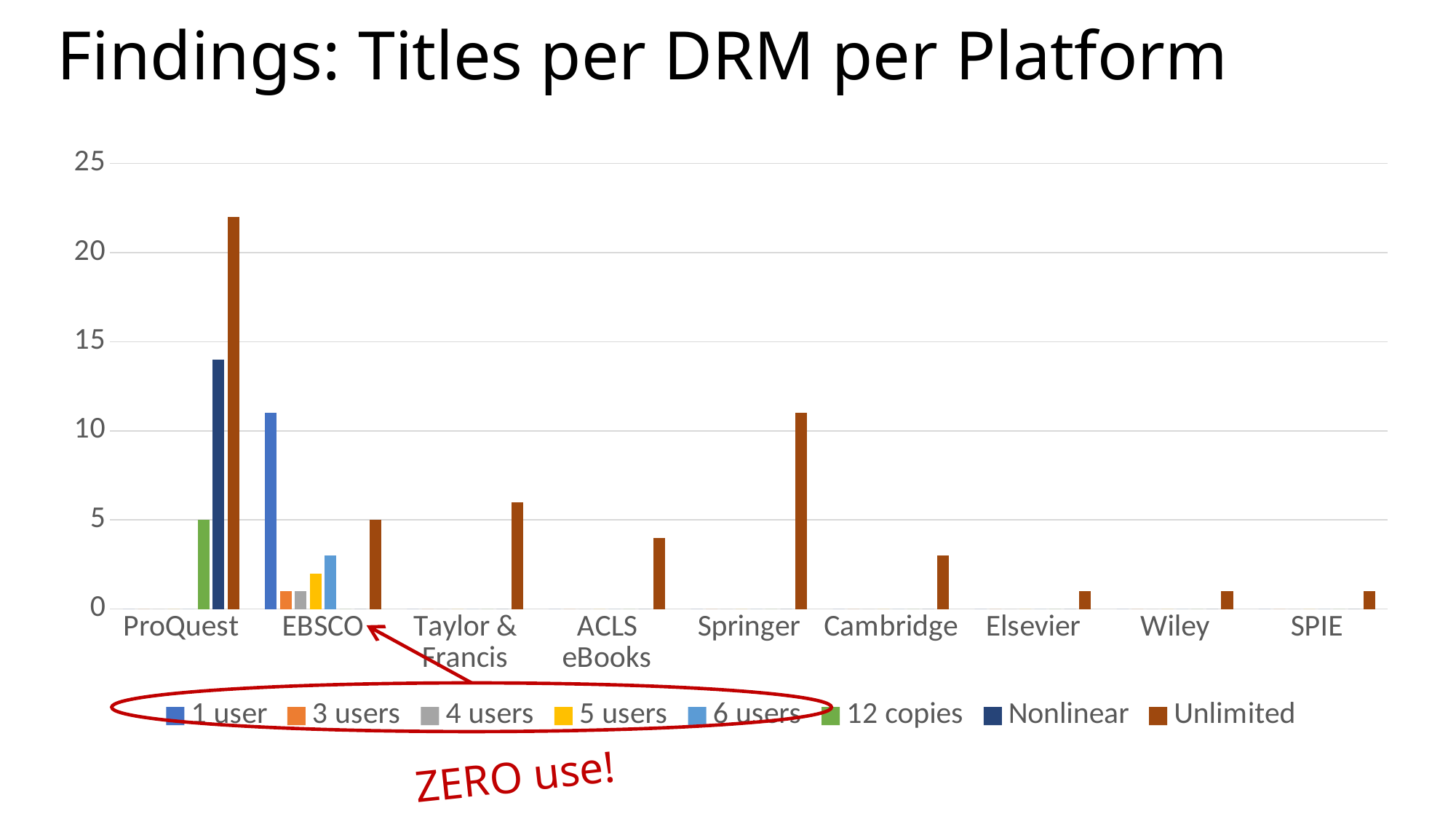
What kind of chart is shown on the slide? bar chart What does the red handwritten annotation below the legend say? ZERO use! Is the Nonlinear value for ProQuest greater or less than 15? less Is the Unlimited value for Springer greater or less than 10? greater How many series does the legend list? 8 Is the Unlimited value for ProQuest greater or less than 20? greater How many platforms are shown on the x axis? 9 Which platform has the highest Unlimited bar? ProQuest Which is larger, the Unlimited value for Springer or the Unlimited value for Cambridge? Springer What is the title of the chart slide? Findings: Titles per DRM per Platform